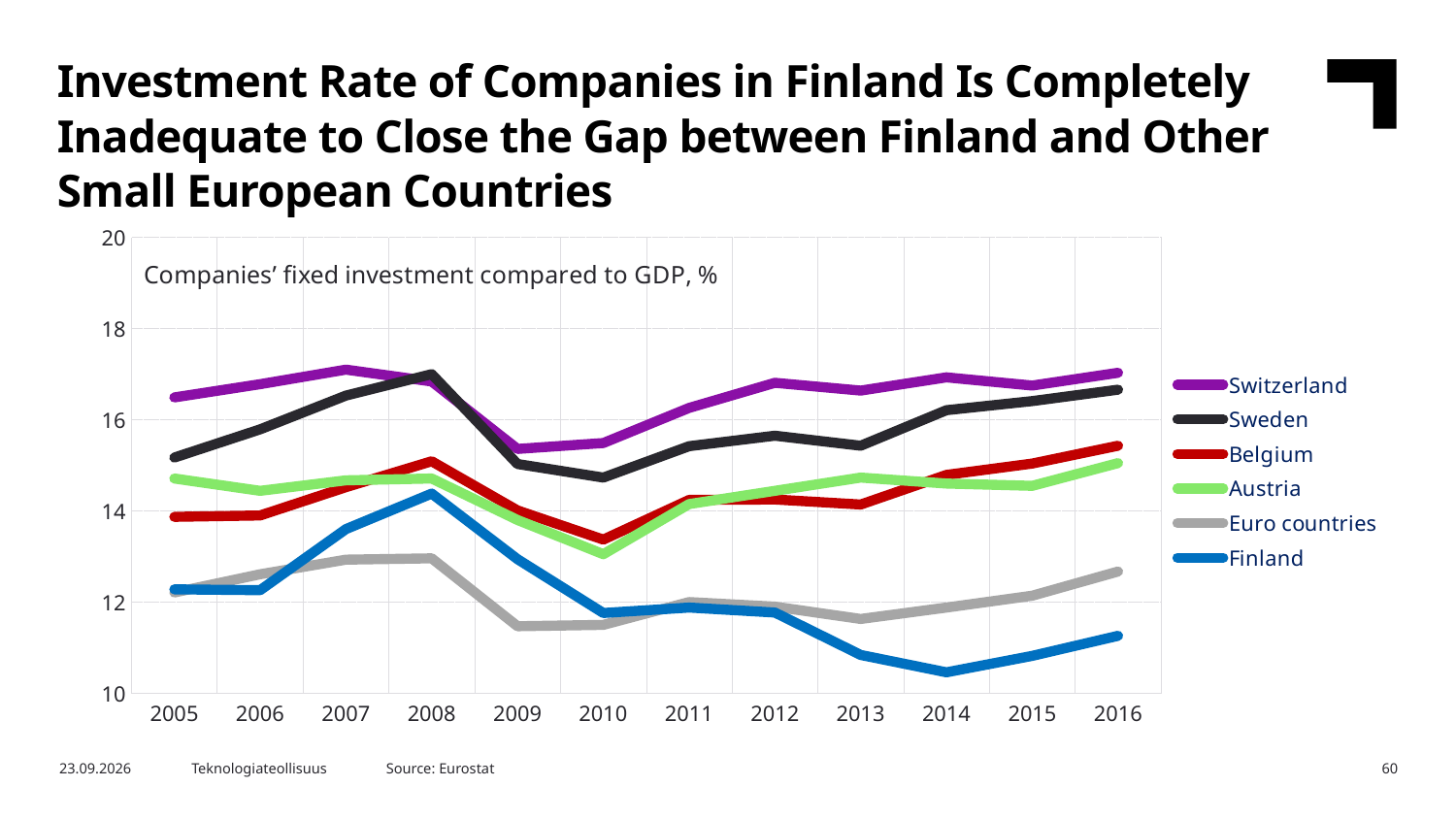
Which country or group has the lowest value in 2016? Finland In which year does Finland reach its highest value? 2008 How many series does the legend list? 6 Which is larger for Finland: the value in 2008 or the value in 2014? 2008 How many years are shown on the x axis? 12 What is the subtitle text shown inside the chart area? Companies' fixed investment compared to GDP, % What type of chart is shown on the slide? Line chart Is the value for Finland in 2014 greater or less than 12? less Is the value for Sweden in 2010 greater or less than 16? less Is the value for Switzerland in 2007 greater or less than 16? greater Does the Finland line rise or fall from 2008 to 2014? Fall Which country or group has the highest value in 2016? Switzerland